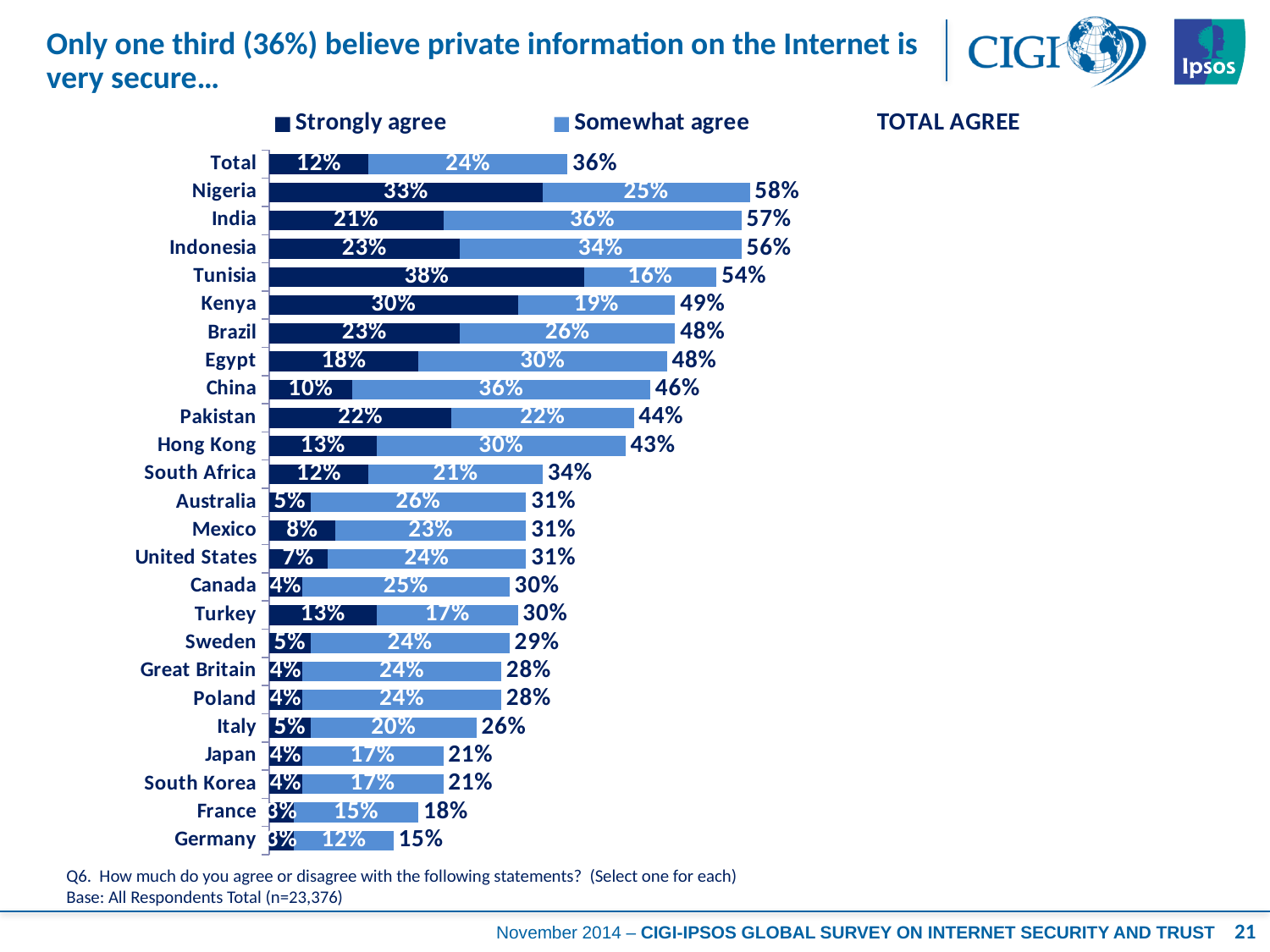
What percentage of respondents in Nigeria strongly agree? 33% How many countries or categories are shown on the chart? 25 Which country has the highest total agree value? Nigeria What is the total agree value for Hong Kong? 43% What is the total agree value for the Total row? 36% Which has a larger Strongly agree value, Kenya or Egypt? Kenya What kind of chart is shown on the slide? Stacked bar chart What is the Somewhat agree value for China? 36% What is the difference between the total agree values for India and Germany? 42% How many series does the legend list? 2 Which country has the highest Strongly agree value? Tunisia Which country has the lowest total agree value? Germany